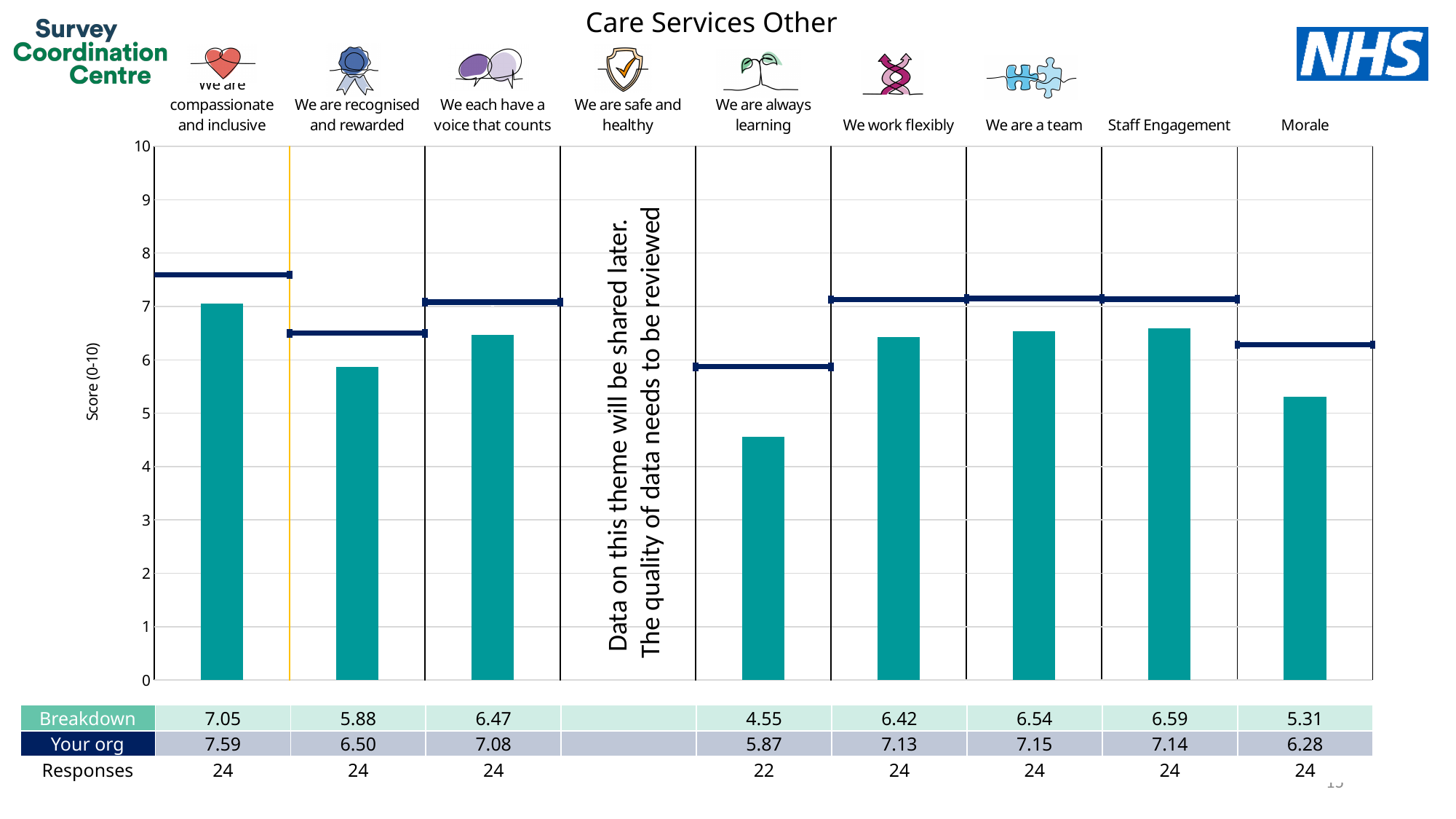
What is the difference between the Your org score and the Breakdown score for Morale? 0.97 Which theme has no data shown on the chart? We are safe and healthy What kind of chart is used to show the Breakdown scores? bar chart Which theme has the highest Breakdown score? We are compassionate and inclusive Which has the higher Breakdown score, 'We work flexibly' or 'Morale'? We work flexibly How many responses are recorded for 'We are always learning'? 22 What is the Breakdown score for 'We are compassionate and inclusive'? 7.05 Is the Breakdown bar for 'We are always learning' greater or less than 5? less How many themes have a Breakdown bar plotted on the chart? 8 What is the title of the chart? Care Services Other What is the Your org score for 'We work flexibly'? 7.13 Which theme has the lowest Breakdown score? We are always learning